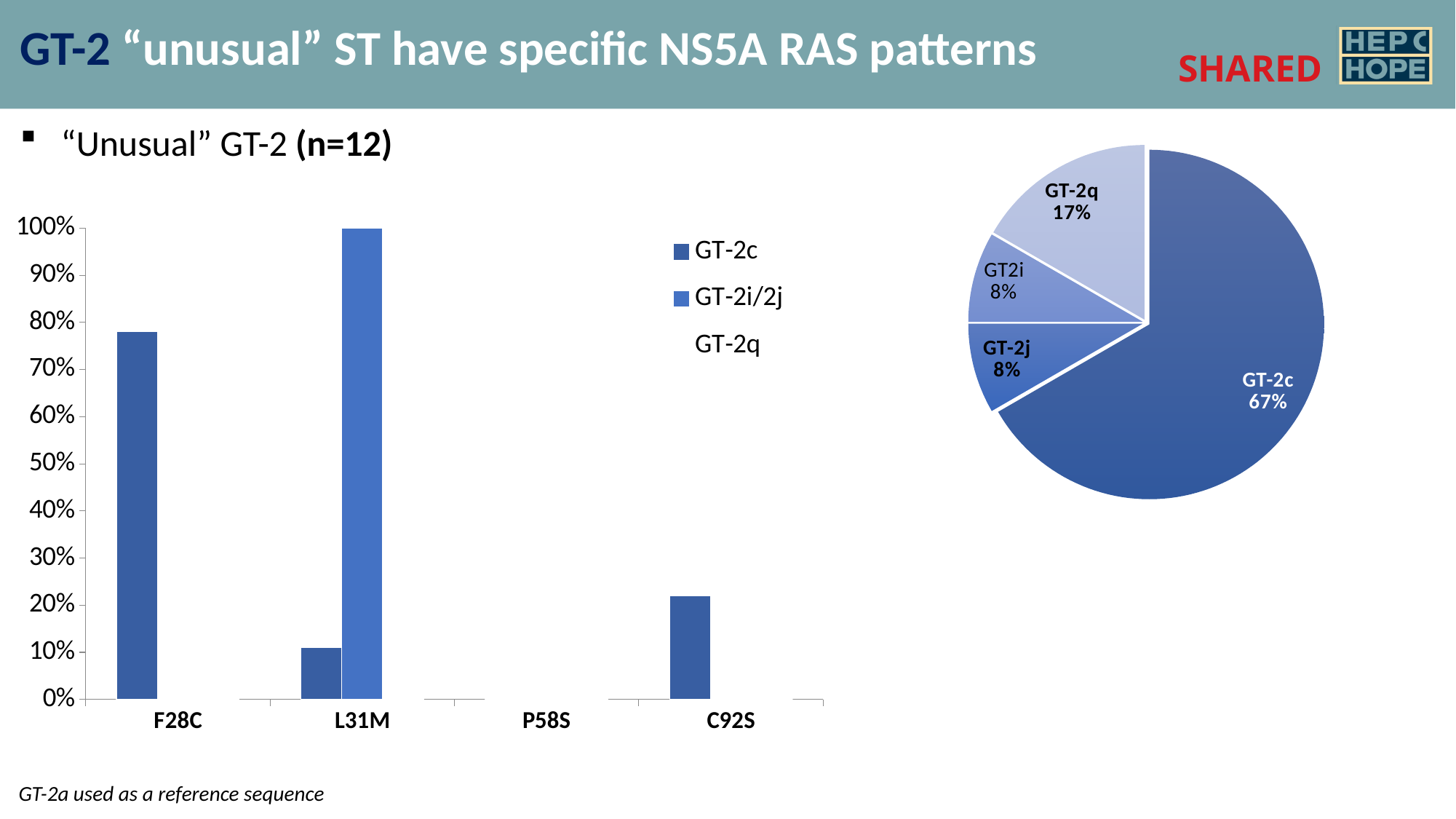
In the pie chart on the right, what share does GT-2c have? 67% In the bar chart on the left, how many series does the legend list? 3 In the pie chart on the right, what is the difference between the GT-2c share and the GT-2q share? 50 percentage points In the bar chart on the left, is the GT-2c value for F28C greater or less than 70%? greater What kind of chart is shown on the left side of the slide? Bar chart In the pie chart on the right, which slice is the largest? GT-2c What kind of chart is shown on the right side of the slide? Pie chart In the pie chart on the right, how many slices are there? 4 In the bar chart on the left, is the GT-2c value for C92S greater or less than 30%? less In the bar chart on the left, what is the value for GT-2i/2j at L31M? 100% In the pie chart on the right, what share does GT-2q have? 17% In the bar chart on the left, how many categories are shown on the x axis? 4